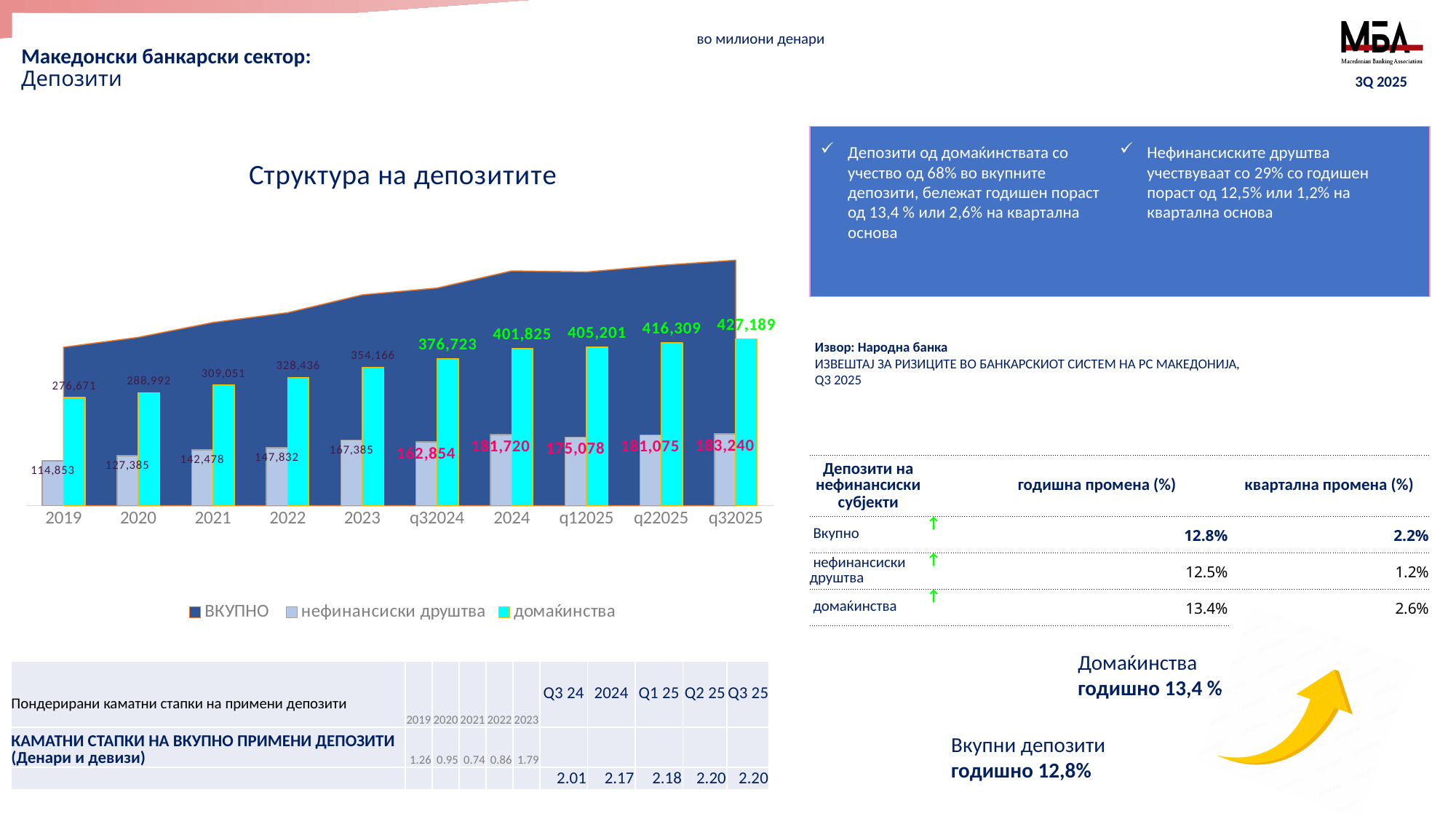
In the chart 'Структура на депозитите', what is the value for домаќинства in q32025? 427,189 In the chart 'Структура на депозитите', what is the value for нефинансиски друштва in q12025? 175,078 How many periods are shown on the x axis of the chart 'Структура на депозитите'? 10 In the chart 'Структура на депозитите', which period has the lowest value for нефинансиски друштва? 2019 In the chart 'Структура на депозитите', what is the value for нефинансиски друштва in 2021? 142,478 In the chart 'Структура на депозитите', which period has the highest value for домаќинства? q32025 In the chart 'Структура на депозитите', which is larger in 2024: домаќинства or нефинансиски друштва? домаќинства In the chart 'Структура на депозитите', what is the difference between the нефинансиски друштва values for 2024 and 2023? 14,335 In the chart 'Структура на депозитите', what is the difference between the домаќинства values for q32025 and q22025? 10,880 How many series does the legend of the chart 'Структура на депозитите' list? 3 In the chart 'Структура на депозитите', what is the value for домаќинства in 2023? 354,166 In the chart 'Структура на депозитите', do the домаќинства values rise or fall from 2019 to q32025? rise